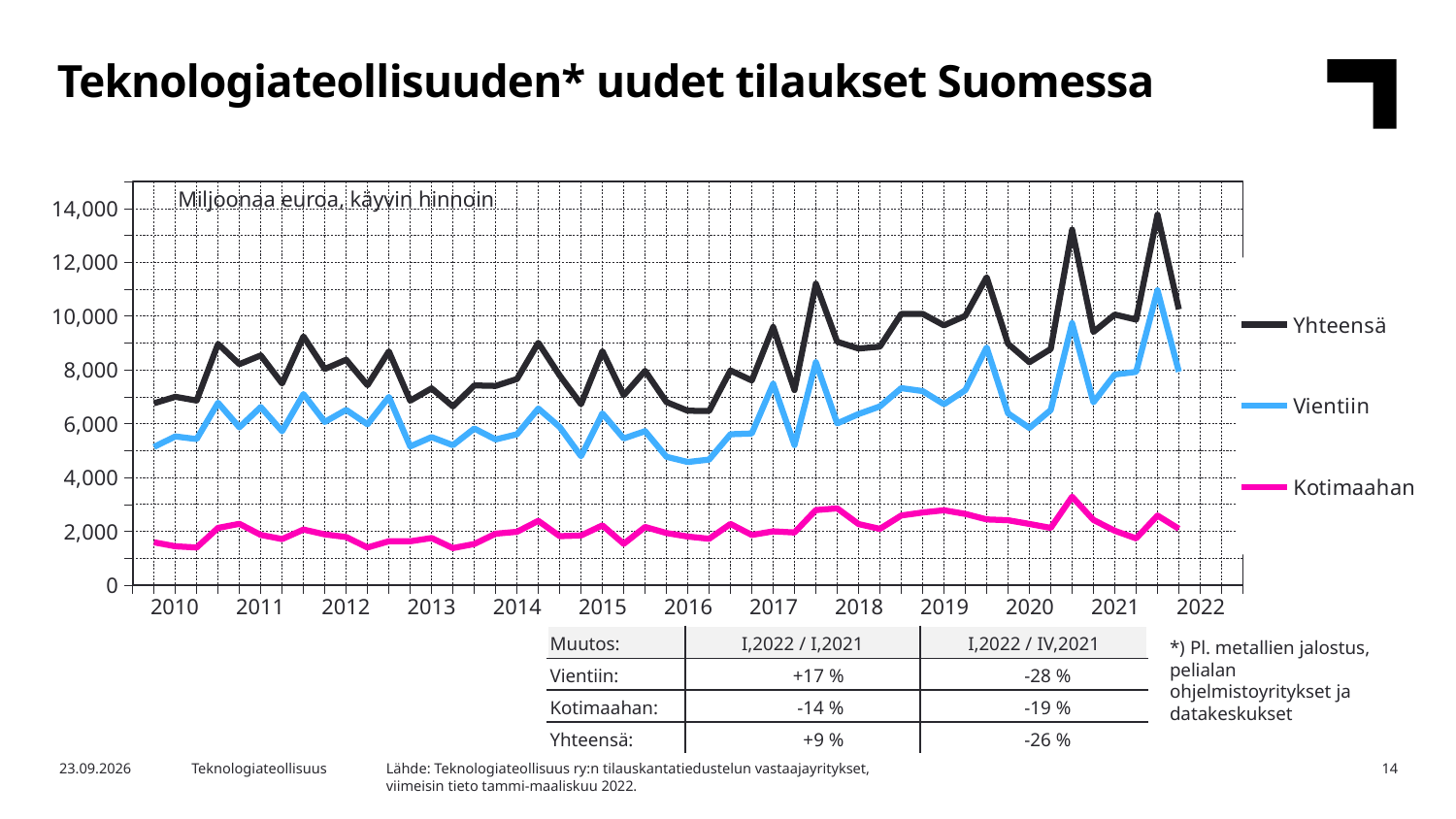
Which series has the lowest values throughout the chart? Kotimaahan What are the three series listed in the chart legend? Yhteensä, Vientiin, Kotimaahan Is the value for Vientiin at the start of 2016 greater or less than 6,000? less What kind of chart is shown on the slide? line chart Is the value for Kotimaahan at the start of 2010 greater or less than 4,000? less How many years are labeled on the x axis? 13 How many series does the chart legend list? 3 Which series is larger in 2018, Vientiin or Kotimaahan? Vientiin Which series reaches the highest value on the chart? Yhteensä What unit note is printed inside the chart area? Miljoonaa euroa, käyvin hinnoin Is the peak value of Vientiin in late 2021 greater or less than 10,000? greater